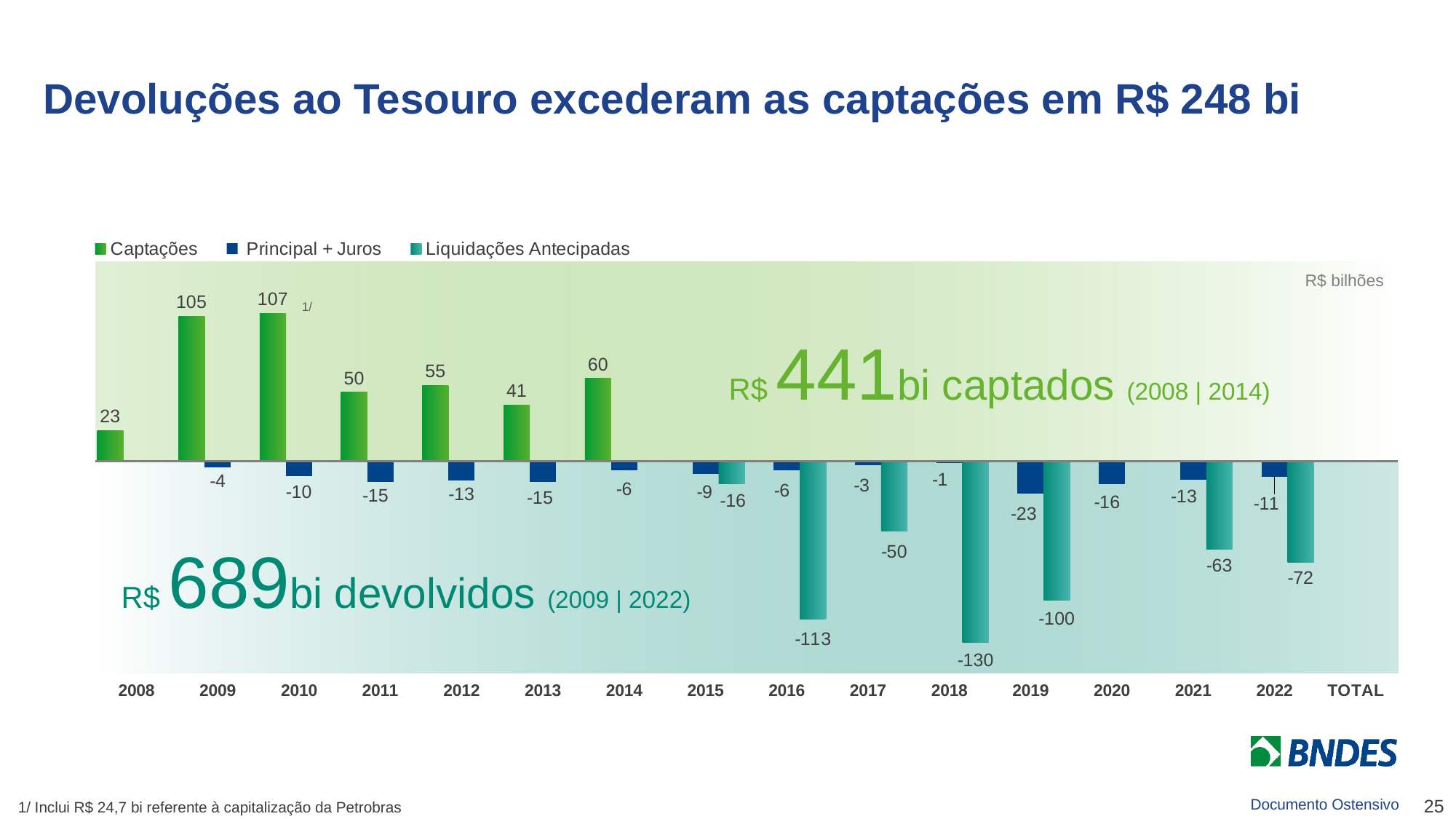
Do the Captações values rise or fall from 2008 to 2010? Rise Which year has the highest Captações value? 2010 What is the value of Captações for 2010? 107 What is the value of Principal + Juros for 2018? -1 How many series does the legend list? 3 What unit is indicated in the top right corner of the chart? R$ bilhões What is the value of Liquidações Antecipadas for 2018? -130 Which year has the lowest (most negative) Liquidações Antecipadas value? 2018 What is the value of Principal + Juros for 2019? -23 What is the difference between the Captações values for 2009 and 2008? 82 Which year has the larger magnitude of Liquidações Antecipadas, 2016 or 2019? 2016 What kind of chart is shown on the slide? Bar chart